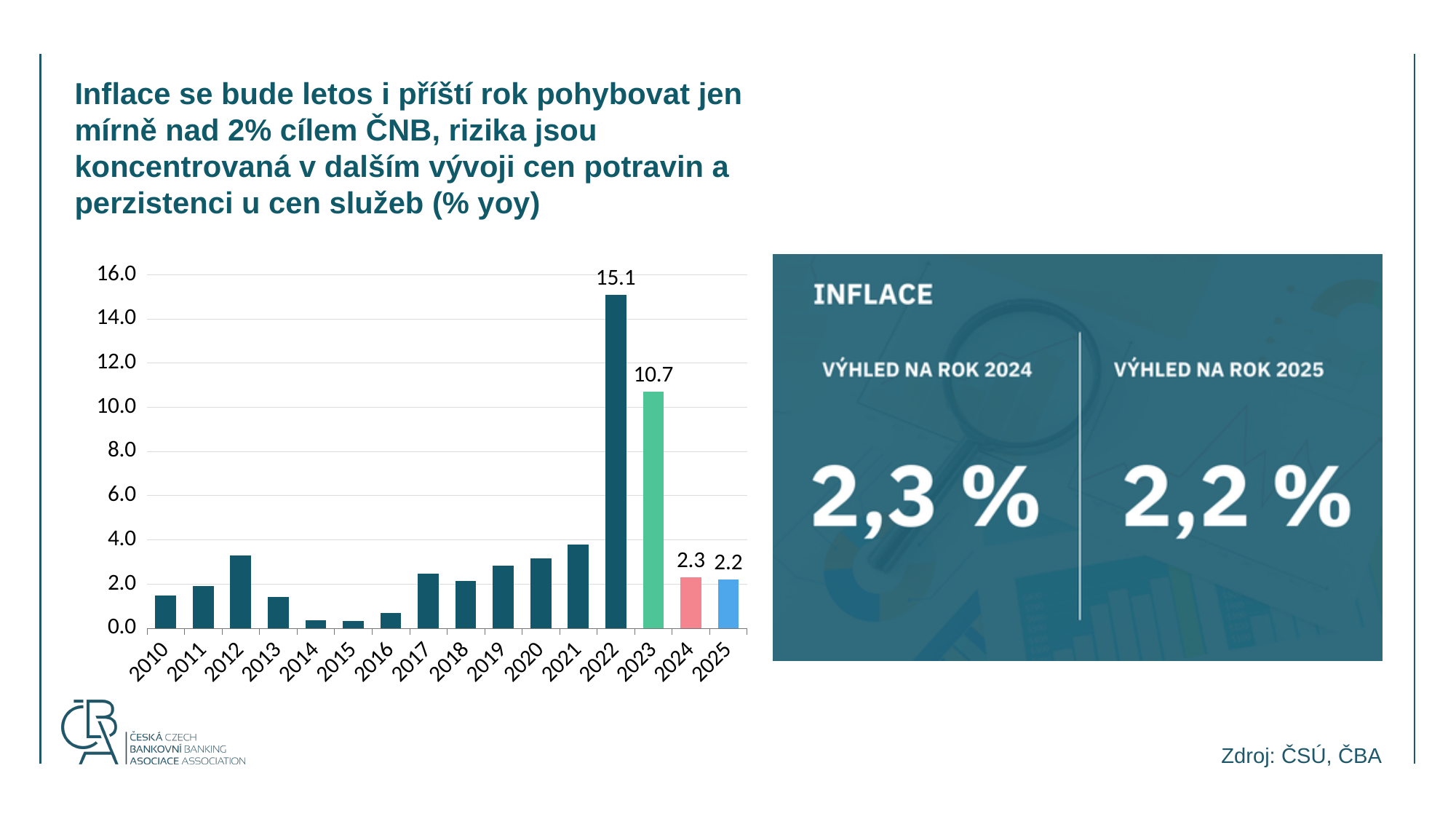
Which is larger, the value for 2024 or the value for 2025? 2024 What kind of chart is shown on the slide? bar chart What is the value for 2022 in the bar chart? 15.1 How many years are shown on the x axis of the bar chart? 16 What is the value for 2024 in the bar chart? 2.3 Which year has the highest value in the bar chart? 2022 Is the value for 2021 greater or less than 2.0? greater What is the value for 2025 in the bar chart? 2.2 What is the difference between the values for 2022 and 2023? 4.4 What is the value for 2023 in the bar chart? 10.7 Do the values rise or fall from 2022 to 2025? fall Is the value for 2014 greater or less than 2.0? less